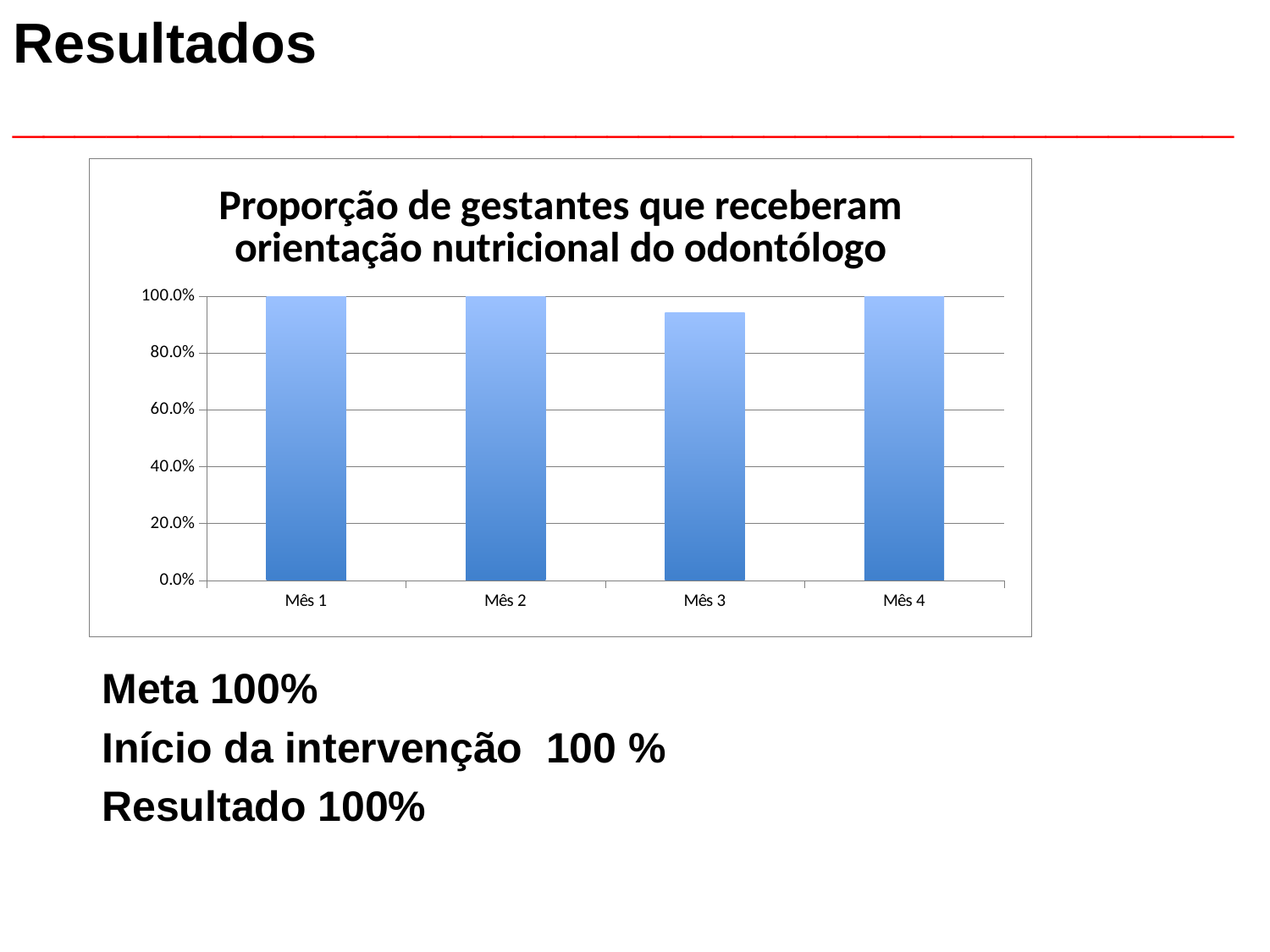
How many months (categories) are plotted in the chart? 4 Which month has the lowest value? Mês 3 Is the value for Mês 3 greater or less than 100.0%? less Is the value for Mês 3 greater or less than 80.0%? greater What type of chart is shown on the slide? bar chart What is the highest value shown on the vertical axis? 100.0% What is the title of the chart? Proporção de gestantes que receberam orientação nutricional do odontólogo What is the value for Mês 2? 100.0% What is the value for Mês 4? 100.0% What is the value for Mês 1? 100.0% Which is larger, the value for Mês 2 or the value for Mês 3? Mês 2